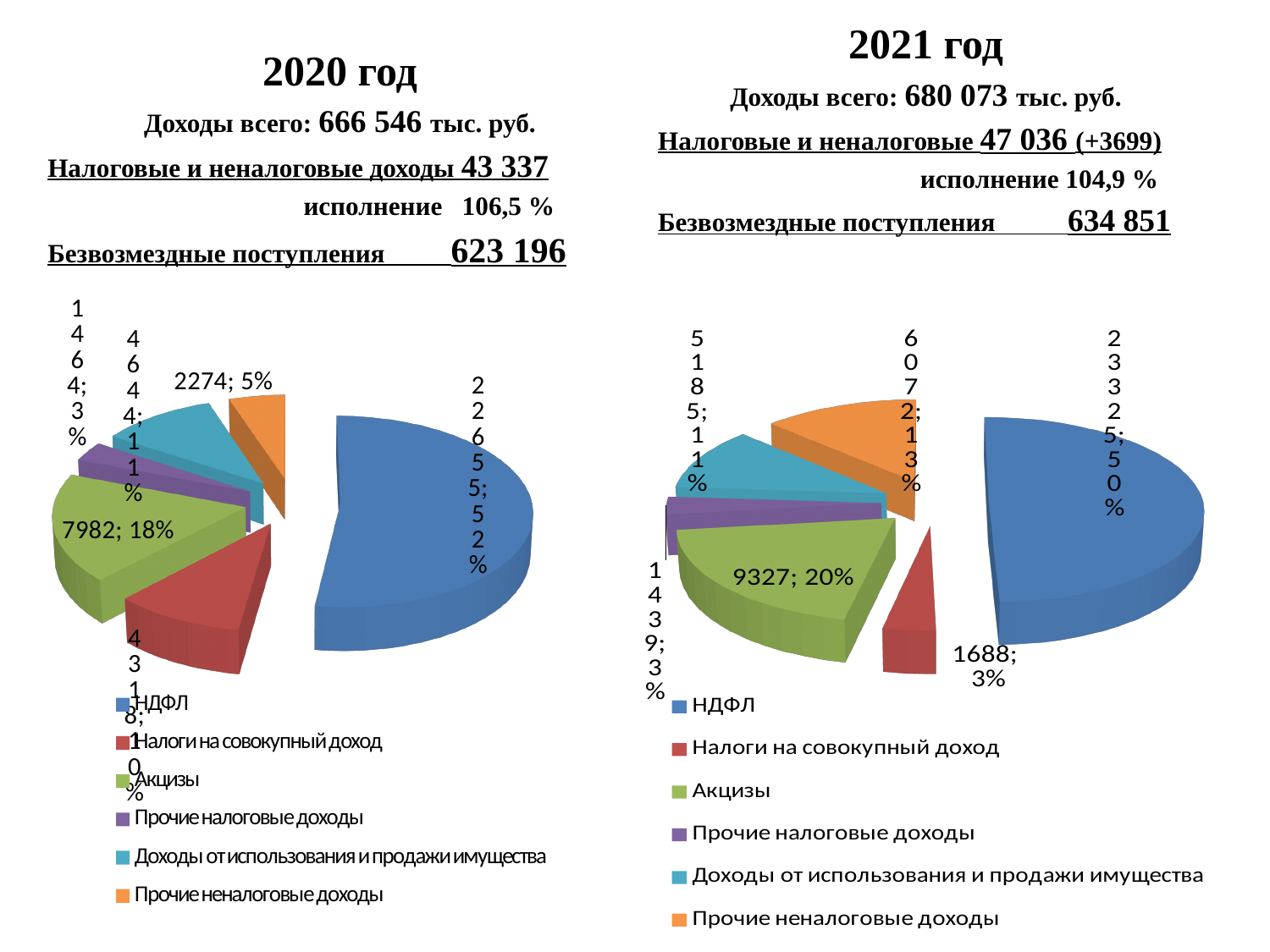
On the 2020 chart, what is the value shown for Акцизы? 7982; 18% On the 2020 chart, which category has the smallest slice? Прочие налоговые доходы What type of chart is used for the 2020 data? Pie chart On the 2021 chart, which category has the largest slice? НДФЛ On the 2020 chart, what share of the pie does НДФЛ take? 52% On the 2021 chart, what share of the pie does НДФЛ take? 50% On the 2021 chart, what is the value shown for Акцизы? 9327; 20% On the 2021 chart, which is larger: Акцизы or Прочие неналоговые доходы? Акцизы How many categories does the legend of the 2021 chart list? 6 On the 2021 chart, what is the value shown for Налоги на совокупный доход? 1688; 3% On the 2020 chart, what is the value shown for Прочие неналоговые доходы? 2274; 5% What is the difference between the Акцизы value on the 2021 chart (9327) and on the 2020 chart (7982)? 1345